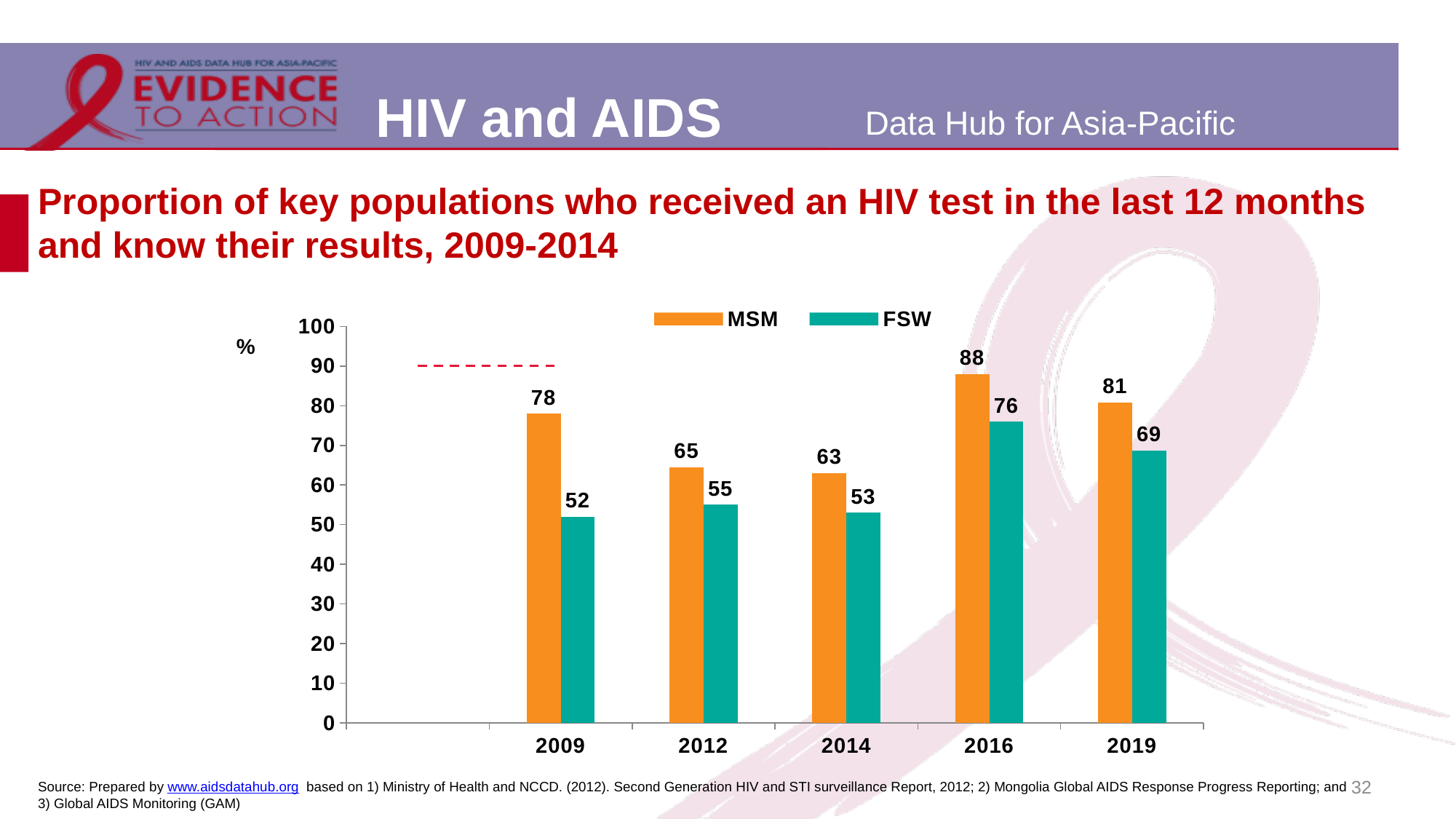
How many years are shown on the x axis? 5 In which year is the MSM value highest? 2016 What is the value for FSW in 2019? 69 What is the difference between the MSM and FSW values in 2014? 10 What is the value for FSW in 2009? 52 Which colour represents the FSW series in the legend? Teal (green) What kind of chart is shown on the slide? Bar chart In which year is the FSW value lowest? 2009 Does the FSW value rise or fall from 2014 to 2016? Rise Which is larger in 2012, the MSM value or the FSW value? MSM What is the value for MSM in 2016? 88 How many series does the legend list? 2